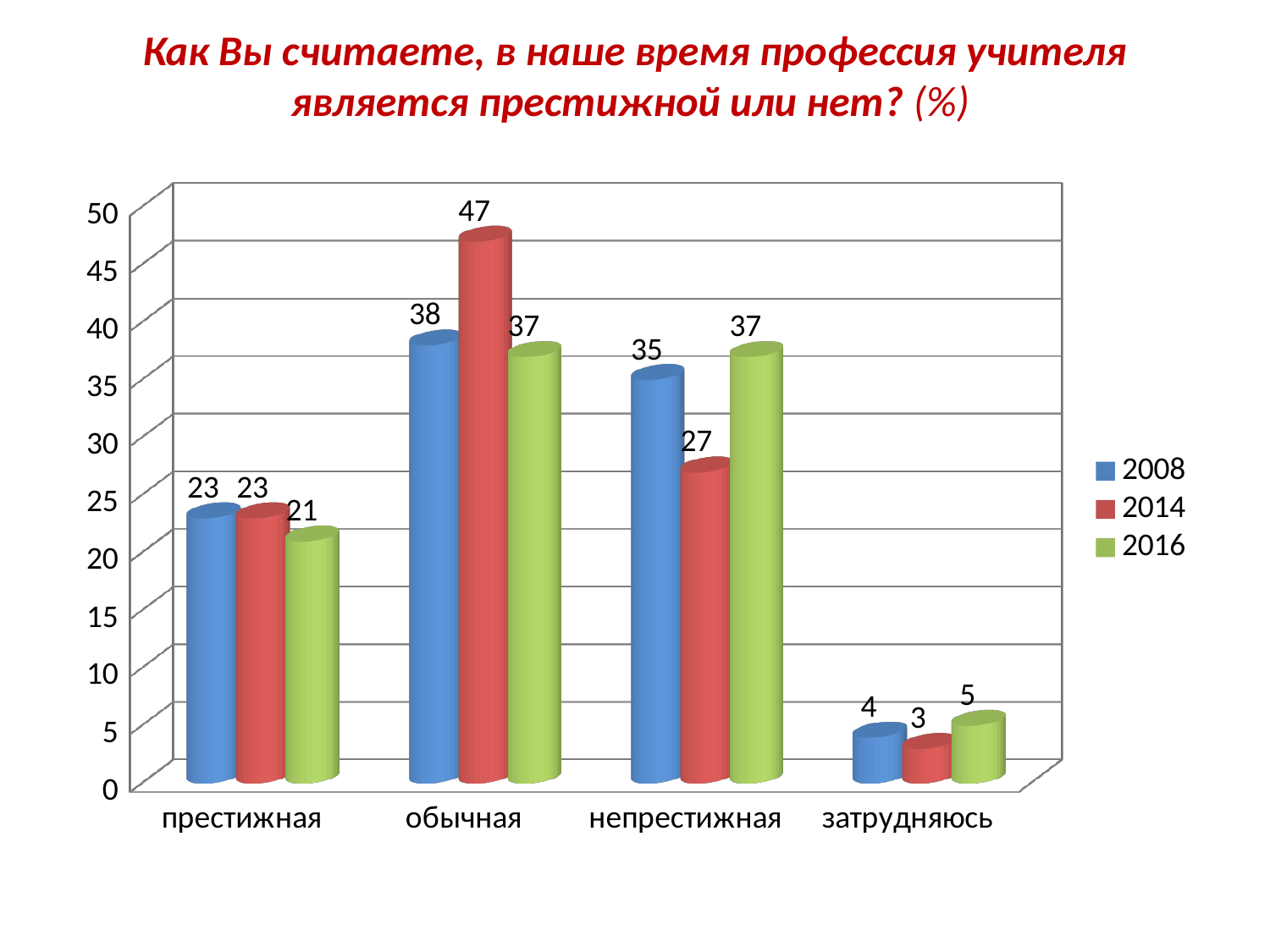
What is the value for "непрестижная" in the 2016 series? 37 What is the value for "престижная" in the 2008 series? 23 Which category has the highest value in the 2014 series? обычная What kind of chart is shown on the slide? bar chart How many series does the legend list? 3 What is the value for "затрудняюсь" in the 2014 series? 3 Which is larger for "непрестижная": the 2008 value or the 2014 value? 2008 Which category has the lowest value in the 2008 series? затрудняюсь What is the difference between the 2014 and 2008 values for "обычная"? 9 Which colour represents the 2016 series in the legend? green What is the value for "обычная" in the 2014 series? 47 How many categories are shown on the x axis? 4